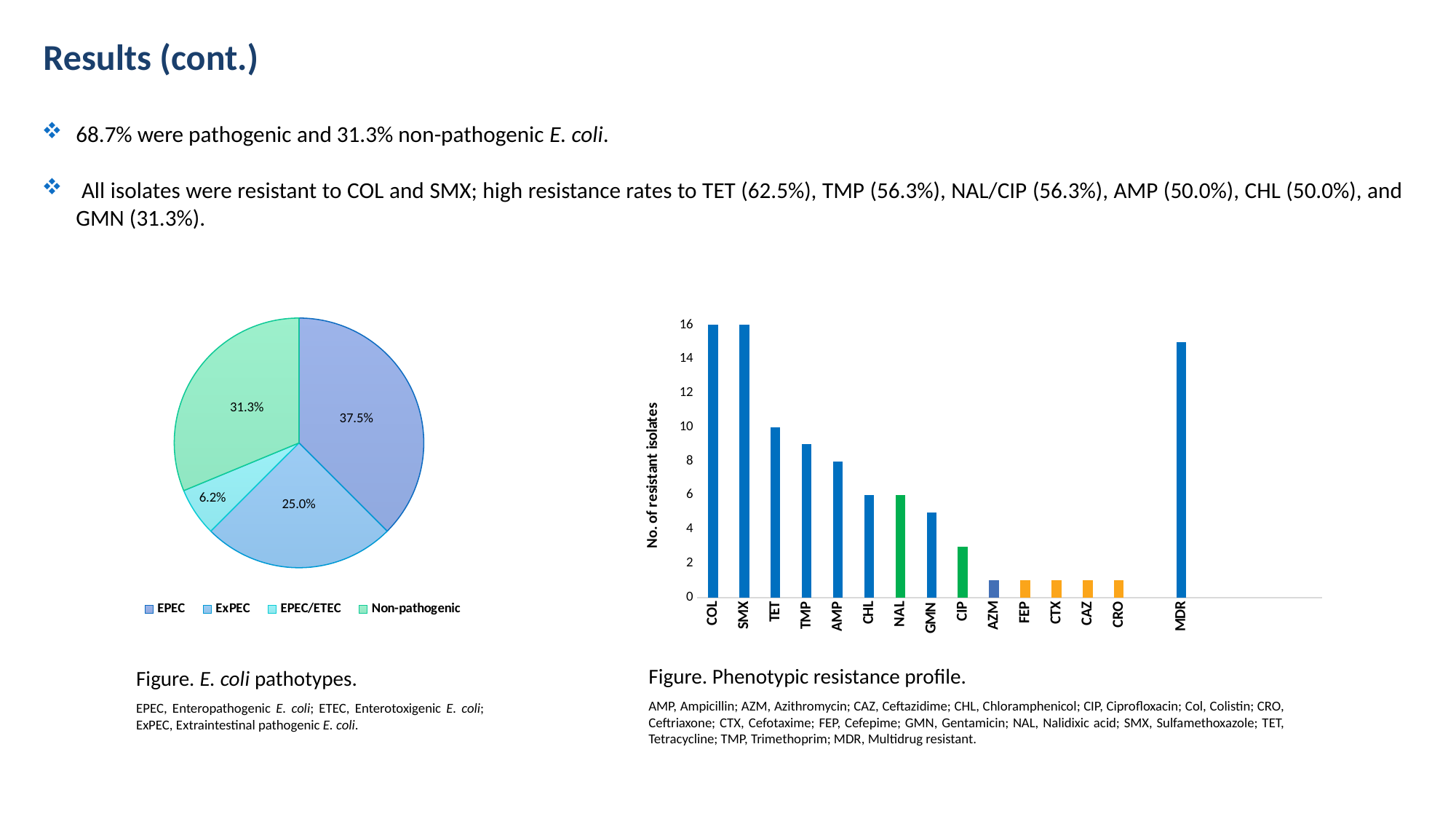
In the Phenotypic resistance profile chart, is the value for CIP greater or less than 4? less In the E. coli pathotypes pie chart, what share does Non-pathogenic have? 31.3% How many antibiotic/resistance categories are shown on the x axis of the Phenotypic resistance profile chart? 15 How many slices does the E. coli pathotypes pie chart have? 4 In the E. coli pathotypes pie chart, which pathotype has the smallest slice? EPEC/ETEC In the E. coli pathotypes pie chart, what share does EPEC have? 37.5% What kind of chart is the Phenotypic resistance profile figure? Bar chart In the E. coli pathotypes pie chart, what is the difference between the EPEC and ExPEC shares? 12.5% What is the y-axis label of the Phenotypic resistance profile chart? No. of resistant isolates In the Phenotypic resistance profile chart, is the value for MDR greater or less than 14? greater In the Phenotypic resistance profile chart, which is larger, TET or GMN? TET In the Phenotypic resistance profile chart, how many resistant isolates are shown for COL? 16